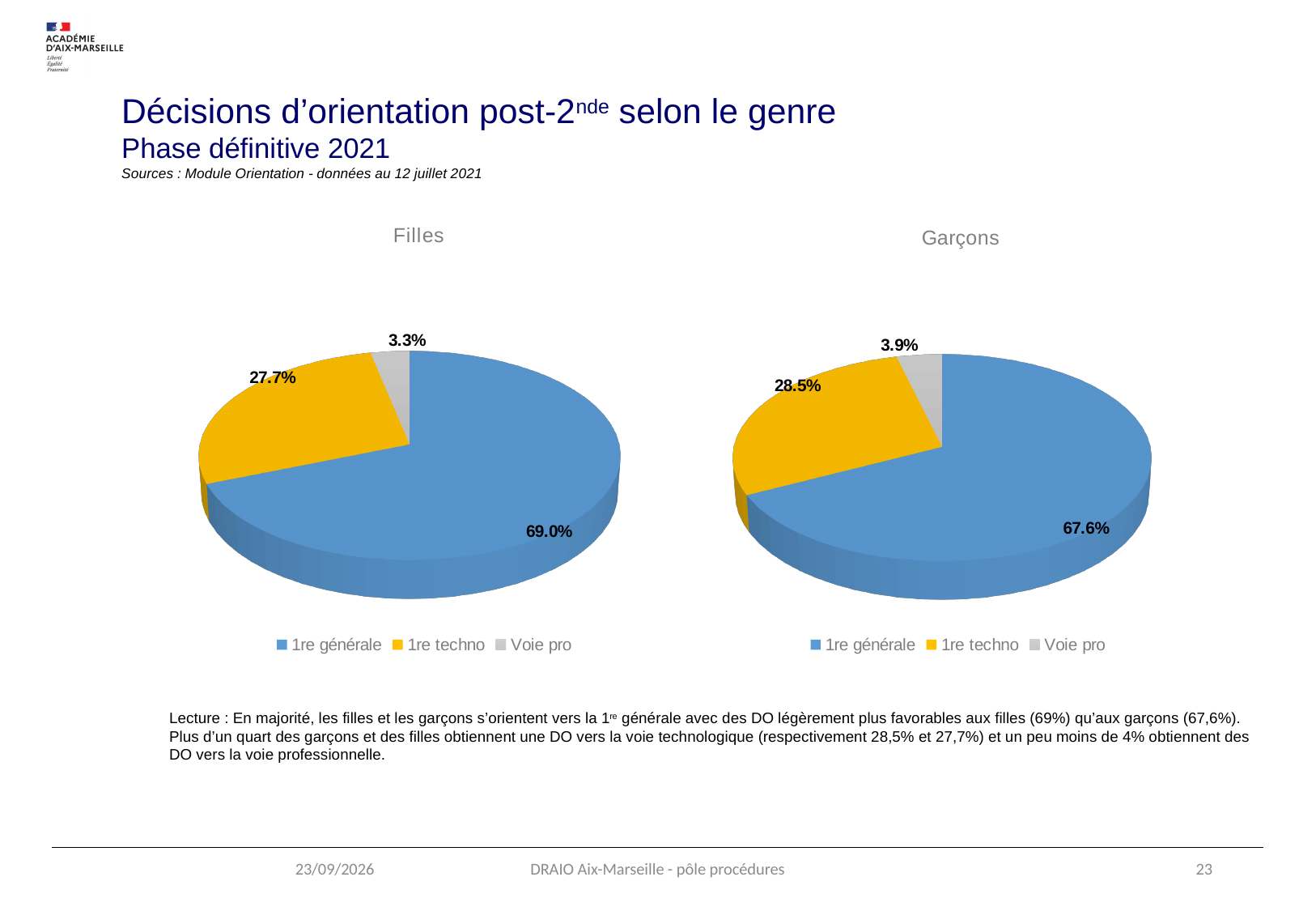
In the 'Filles' pie chart, which category has the smallest slice? Voie pro In the 'Garçons' pie chart, which colour represents Voie pro? Grey In the 'Garçons' pie chart, what share goes to 1re techno? 28.5% In the 'Filles' pie chart, what share goes to Voie pro? 3.3% What type of chart is used for 'Filles'? Pie chart How many slices does the 'Filles' pie chart have? 3 What is the difference between the 1re générale share for Filles and for Garçons? 1.4 percentage points How many entries does the legend of the 'Garçons' chart list? 3 In the 'Garçons' pie chart, what share goes to Voie pro? 3.9% Which is larger: the 1re techno share for Filles or for Garçons? Garçons In the 'Filles' pie chart, what share goes to 1re générale? 69.0% In the 'Garçons' pie chart, which category has the largest slice? 1re générale